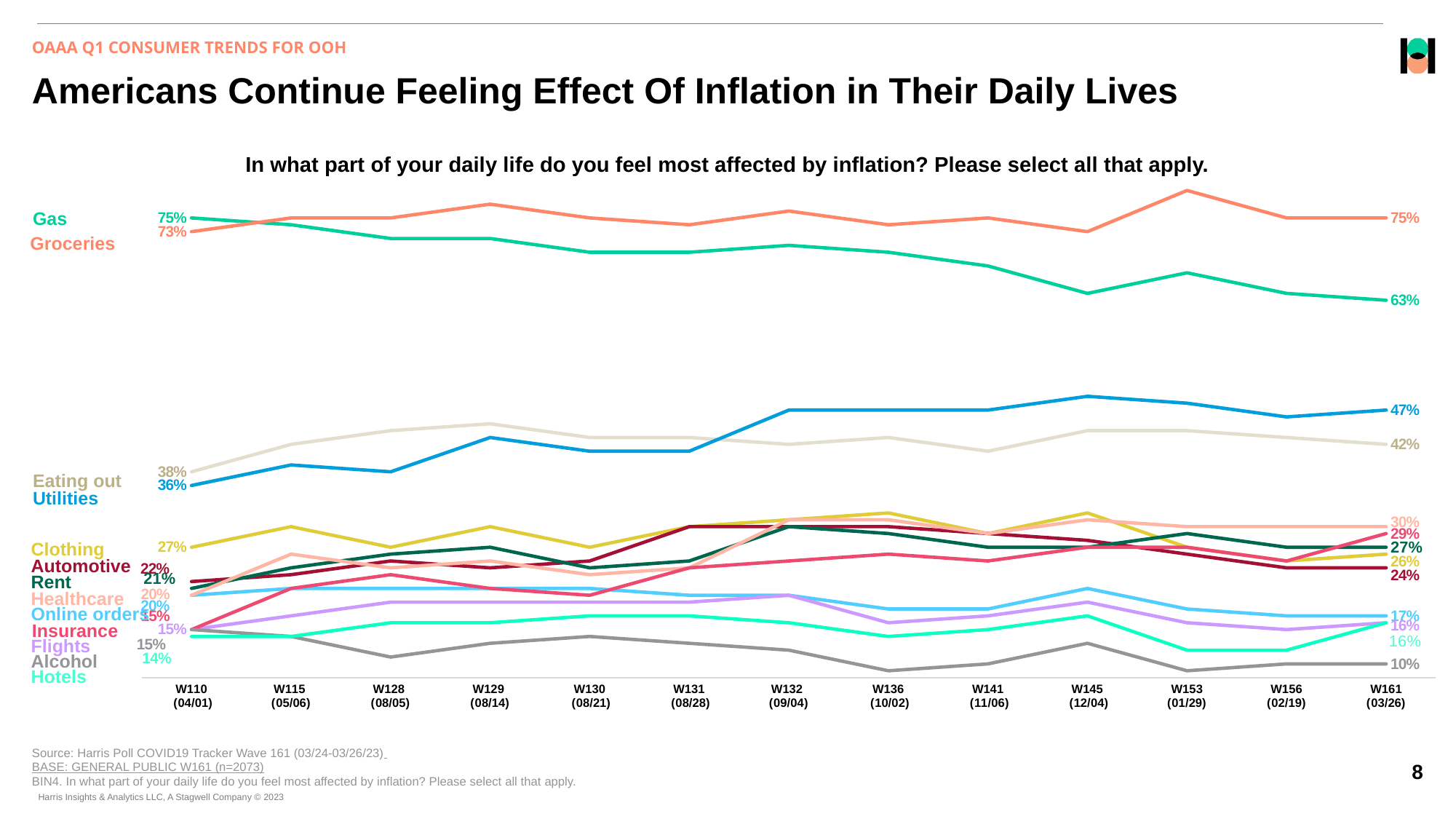
Which category had the highest value at W161 (03/26)? Groceries How many waves (x-axis points) are shown on the chart? 13 What was the value for Utilities at W161 (03/26)? 47% By how many percentage points did the value for Gas change from W110 to W161? 12 percentage points By how many percentage points did the value for Utilities change from W110 to W161? 11 percentage points Which category had the lowest value at W161 (03/26)? Alcohol What was the value for Groceries at W161 (03/26)? 75% Does the Gas line rise or fall from W110 to W161? Falls What was the value for Alcohol at W161 (03/26)? 10% What kind of chart is shown on the slide? Line chart At W110 (04/01), which was higher: Eating out or Utilities? Eating out What was the value for Gas at W110 (04/01)? 75%